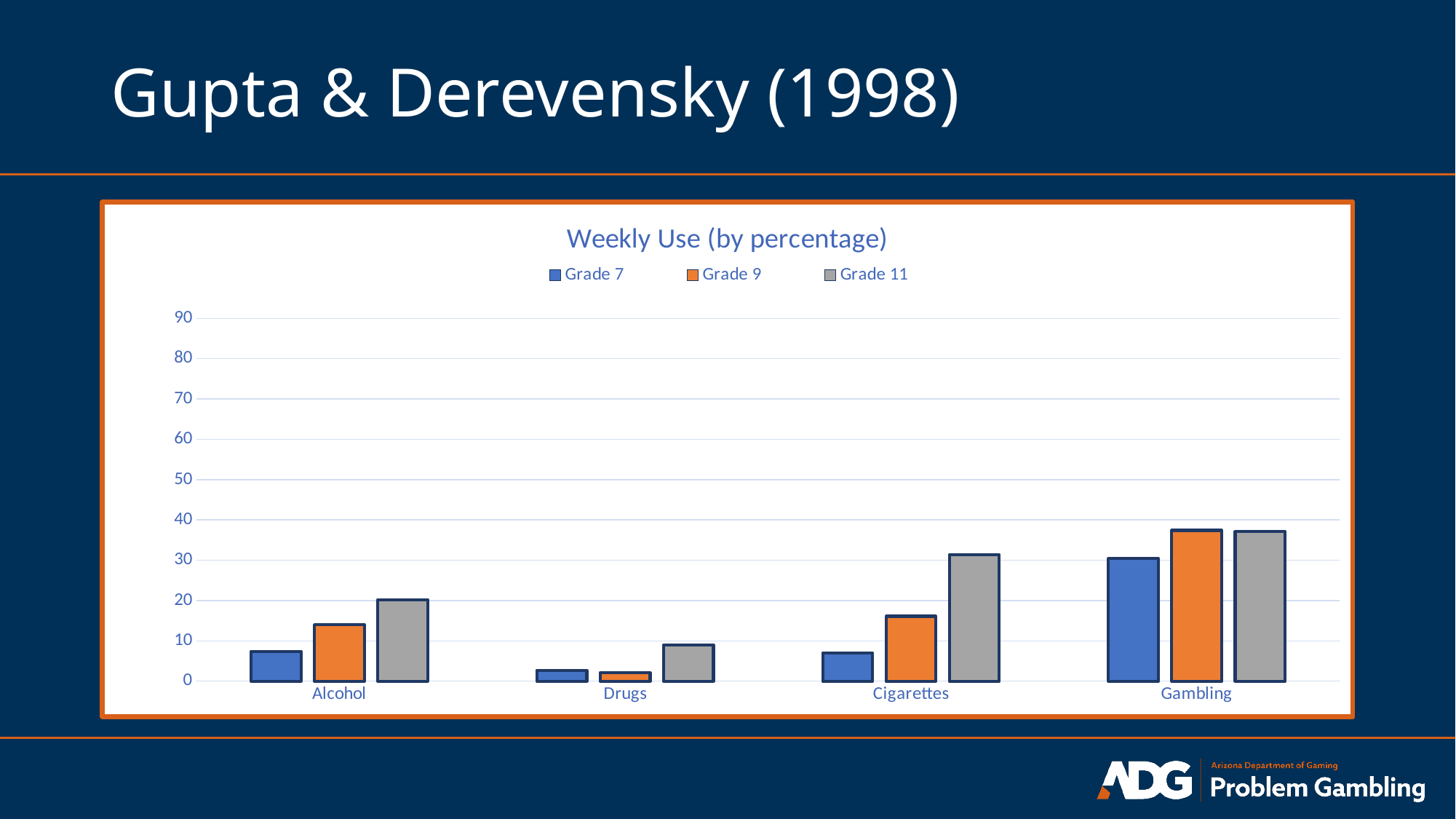
How many series does the legend list? 3 Which category has the highest Grade 7 bar? Gambling Which category has the highest Grade 11 bar? Gambling What is the title of the chart? Weekly Use (by percentage) For Cigarettes, do the values rise or fall from Grade 7 to Grade 11? rise Is the Grade 7 value for Gambling greater or less than 20? greater Is the Grade 11 value for Alcohol greater or less than 10? greater Which category has the lowest Grade 11 bar? Drugs Is the Grade 9 value for Drugs greater or less than 10? less What kind of chart is shown on the slide? Bar chart For Alcohol, which is larger: the Grade 9 value or the Grade 11 value? Grade 11 How many categories are shown on the x axis? 4